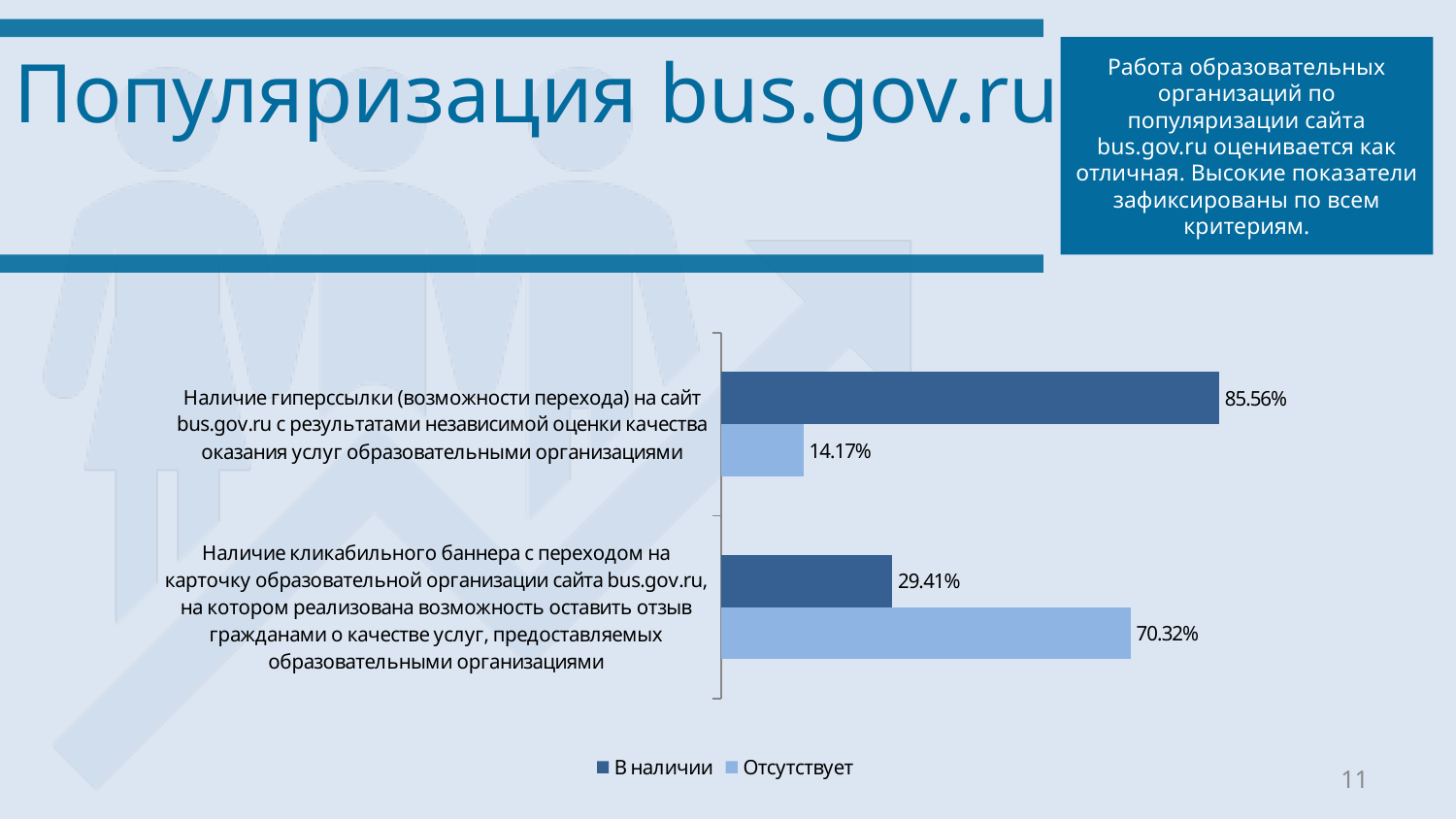
What is the value of "В наличии" for the category about the clickable banner (Наличие кликабильного баннера)? 29.41% For the clickable banner category, which is larger: "В наличии" or "Отсутствует"? Отсутствует How many categories are plotted in the chart? 2 What is the value of "В наличии" for the category about the hyperlink to bus.gov.ru (Наличие гиперссылки)? 85.56% What is the value of "Отсутствует" for the category about the hyperlink to bus.gov.ru (Наличие гиперссылки)? 14.17% Which category has the lowest "Отсутствует" value? Наличие гиперссылки (возможности перехода) на сайт bus.gov.ru Which category has the highest "В наличии" value? Наличие гиперссылки (возможности перехода) на сайт bus.gov.ru What is the value of "Отсутствует" for the category about the clickable banner (Наличие кликабильного баннера)? 70.32% Which legend entry is shown in the darker blue colour? В наличии What kind of chart is shown on the slide? bar chart What is the difference between the "В наличии" values for the hyperlink category and the clickable banner category? 56.15% How many series does the chart legend list? 2